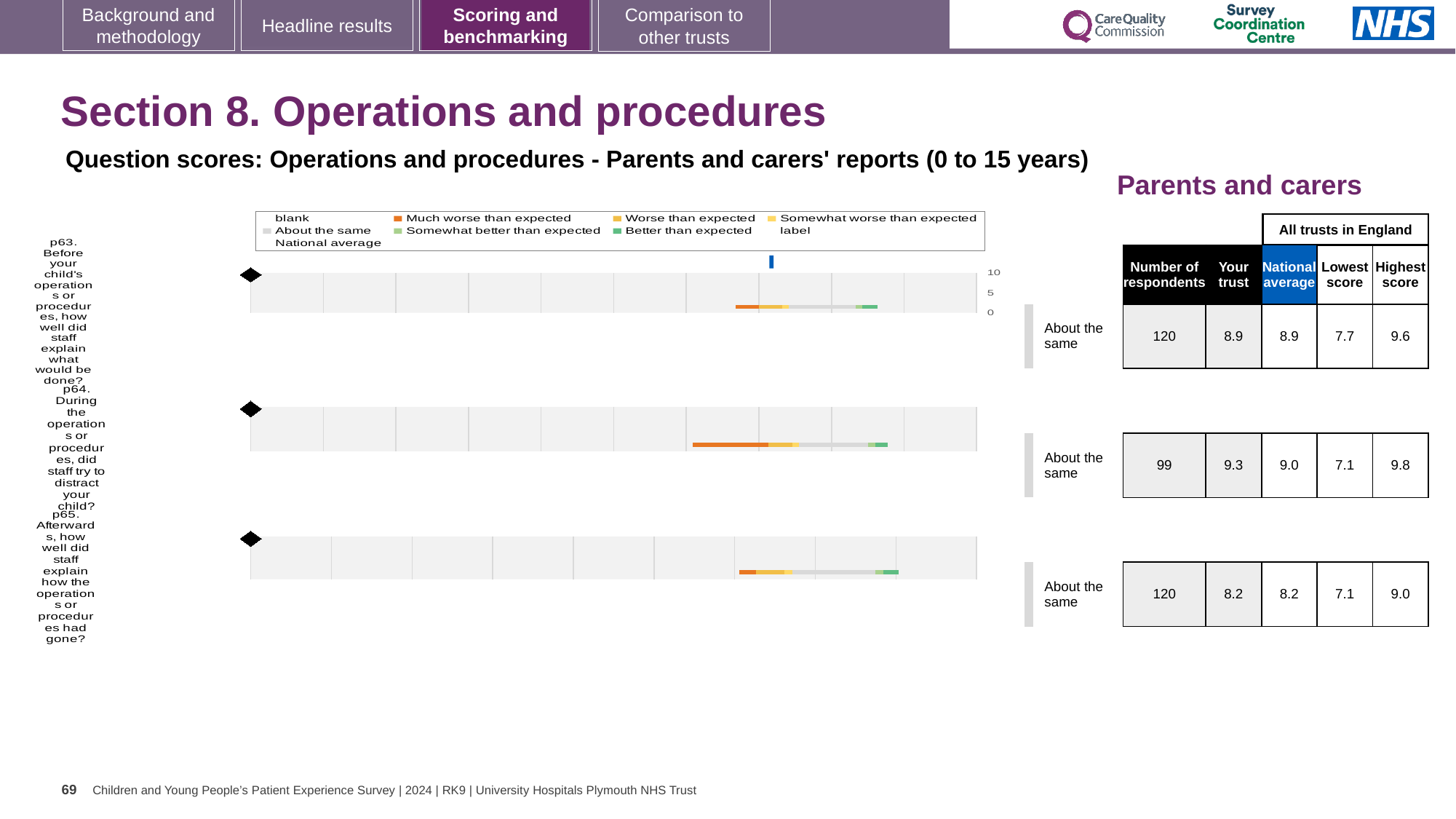
What kind of chart is used for the question scores on this slide? Bar chart How many question charts are plotted on the slide? 3 For the p65 chart (Afterwards, how well did staff explain how the operations or procedures had gone?), what is the difference between the Highest score and the Lowest score? 1.9 For the p64 chart, which is larger: the 'Your trust' score or the National average? Your trust What benchmark category is shown next to the p63 chart? About the same For the p64 chart, how many respondents are listed? 99 Which question chart has the lowest 'Your trust' score? p65 Which question chart has the highest 'Your trust' score? p64 In the legend, what colour represents 'Much worse than expected'? Orange For the p64 chart, what is the Highest score among all trusts in England? 9.8 For the p63 chart (Before your child's operations or procedures, how well did staff explain what would be done?), what is the 'Your trust' score shown in the table? 8.9 For the p64 chart (During the operations or procedures, did staff try to distract your child?), what is the National average score? 9.0